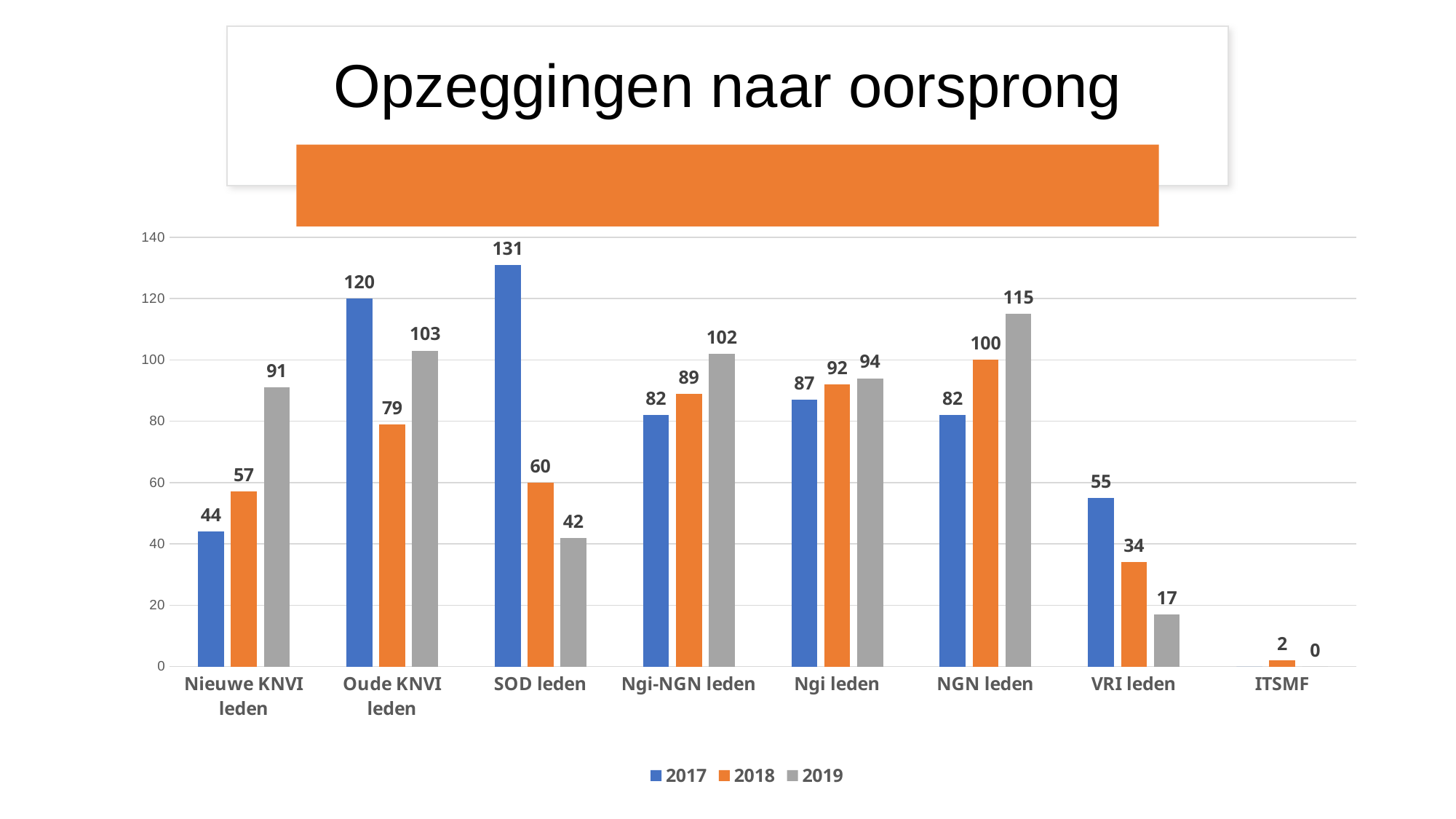
Do the values for Nieuwe KNVI leden rise or fall from 2017 to 2019? rise What is the difference between the 2017 and 2019 values for SOD leden? 89 What is the value for VRI leden in 2018? 34 What is the value for SOD leden in 2017? 131 What is the title of the chart? Opzeggingen naar oorsprong Which is larger for Oude KNVI leden: the 2018 value or the 2019 value? 2019 How many series does the legend list? 3 What kind of chart is shown on the slide? bar chart What is the value for NGN leden in 2019? 115 Which category has the lowest value in the 2018 series? ITSMF How many categories are shown on the x axis? 8 Which category has the highest value in the 2019 series? NGN leden